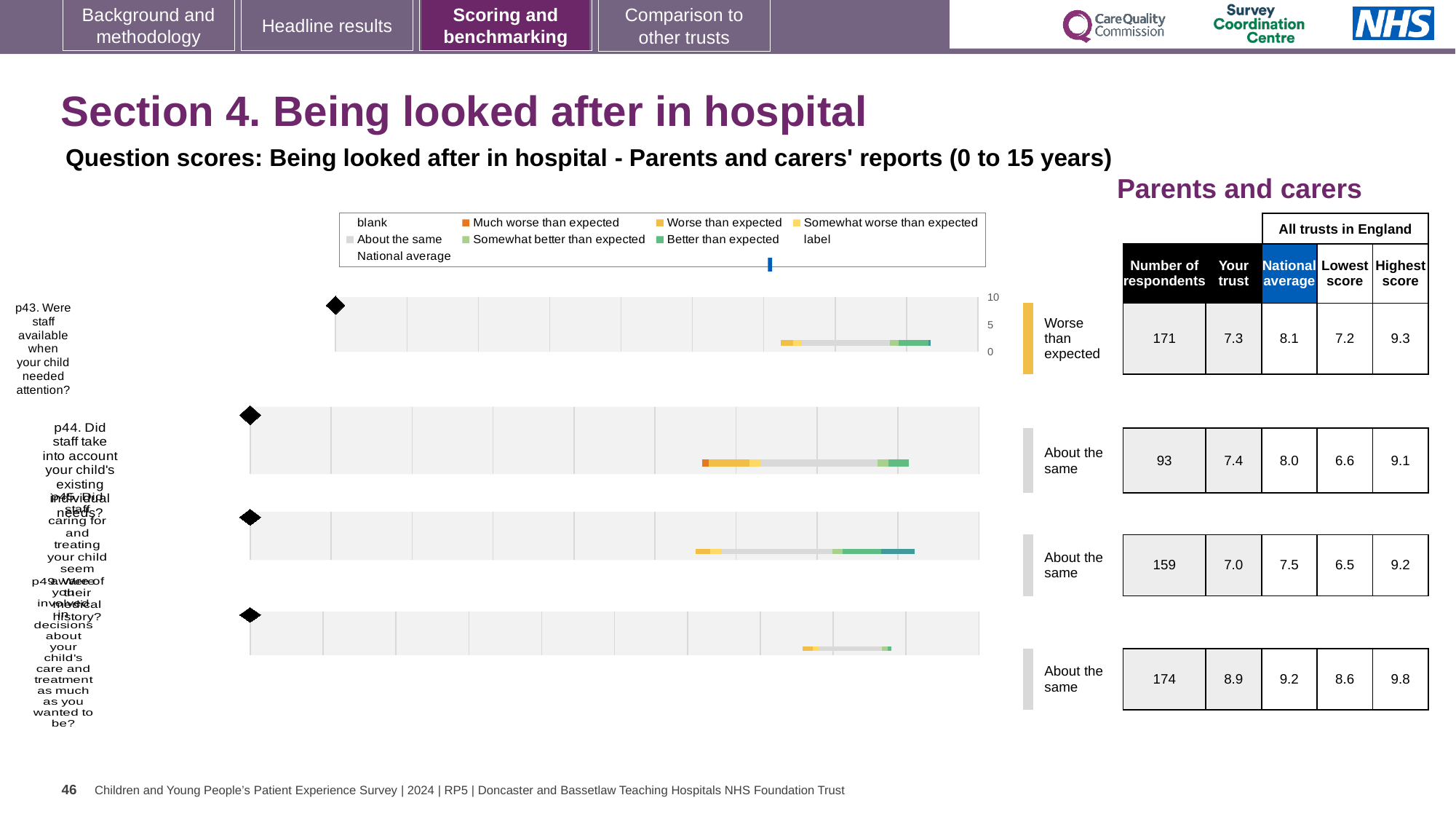
For the first chart (p43), what benchmark rating is given to the trust? Worse than expected What kind of chart is used to show the question scores on this slide? Bar chart For the first chart (p43), what is the difference between the national average and the 'Your trust' score? 0.8 For the first chart (p43. Were staff available when your child needed attention?), what is the 'Your trust' score? 7.3 For the first chart (p43), what is the highest score among all trusts in England? 9.3 Which of the four charts has the lowest 'Your trust' score? The third chart For the first chart (p43), which is larger: the 'Your trust' score or the national average? National average Which of the four charts has the highest 'Your trust' score? The fourth (bottom) chart For the first chart (p43), how many respondents are listed? 171 For the first chart (p43), what is the national average score? 8.1 How many question charts are shown on the slide? 4 For the fourth (bottom) chart, what is the 'Your trust' score? 8.9